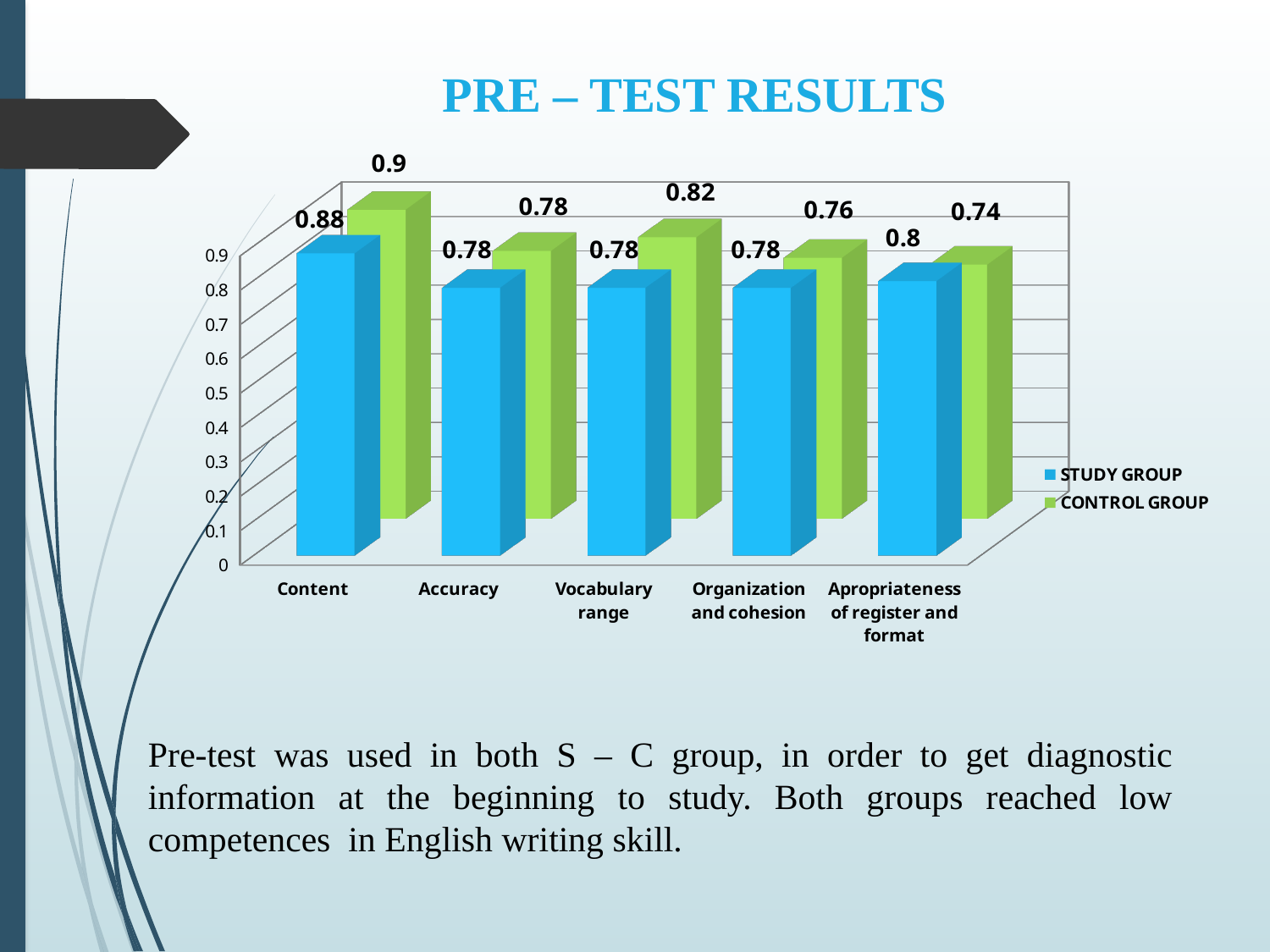
What is the STUDY GROUP value for Content? 0.88 What is the difference between the CONTROL GROUP and STUDY GROUP values for Vocabulary range? 0.04 What kind of chart is shown on the slide? Bar chart Which category has the highest CONTROL GROUP value? Content What is the CONTROL GROUP value for Apropriateness of register and format? 0.74 How many categories are shown on the x axis? 5 How many series does the legend list? 2 What is the CONTROL GROUP value for Vocabulary range? 0.82 Which category has the lowest CONTROL GROUP value? Apropriateness of register and format Which is larger for Apropriateness of register and format: the STUDY GROUP value or the CONTROL GROUP value? STUDY GROUP What is the title of the slide's chart section? PRE – TEST RESULTS What is the STUDY GROUP value for Apropriateness of register and format? 0.8